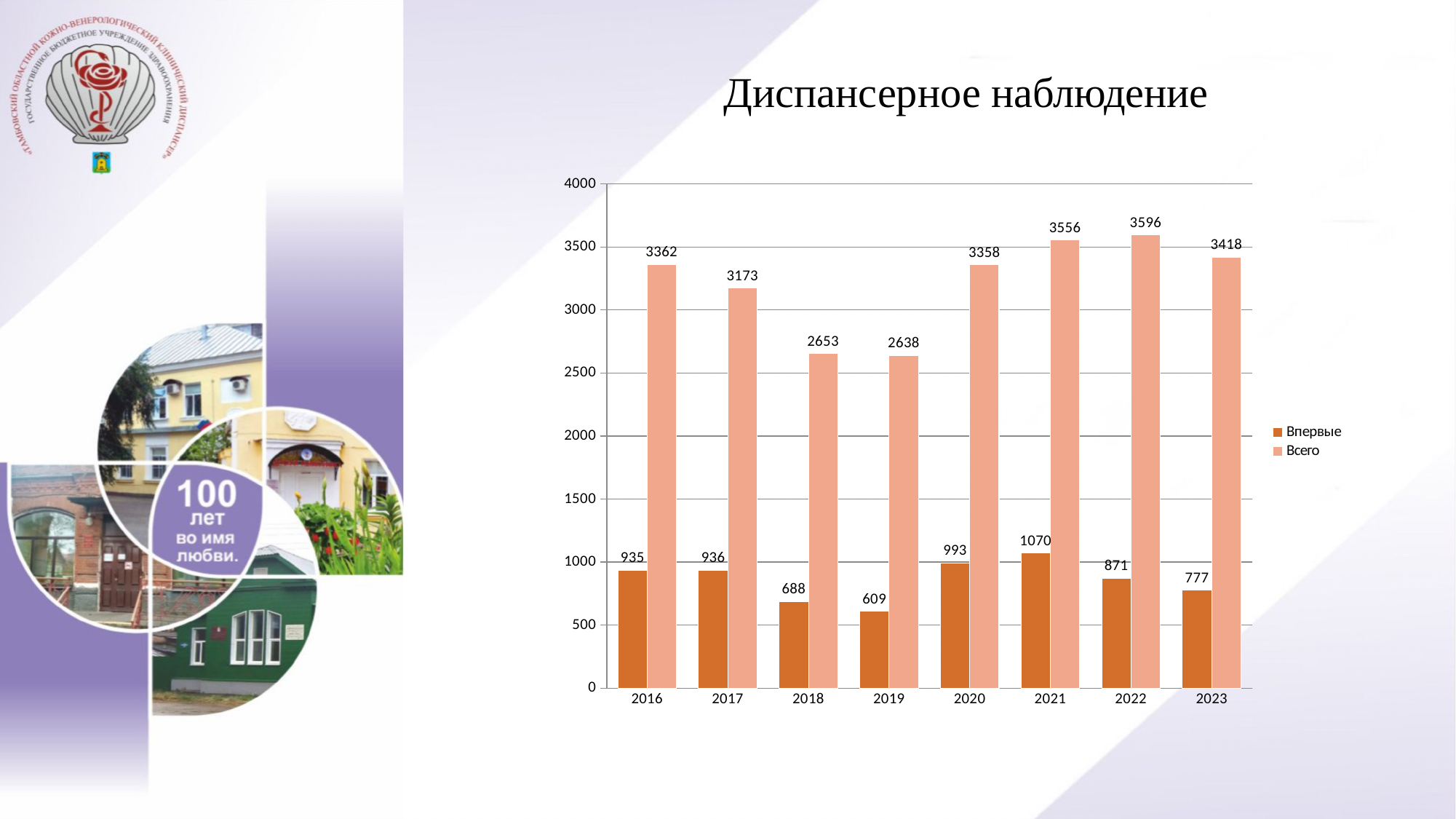
Which is larger, the Всего value for 2018 or for 2019? 2018 Which year has the highest value for Всего? 2022 What kind of chart is shown on the slide? bar chart What is the difference between Всего and Впервые in 2023? 2641 What is the value for Впервые in 2021? 1070 What is the title of the chart? Диспансерное наблюдение What is the value for Всего in 2016? 3362 How many series does the legend list? 2 What is the value for Впервые in 2019? 609 Which year has the lowest value for Впервые? 2019 Is the value for Впервые in 2020 greater or less than 1000? less How many years are shown on the x axis? 8